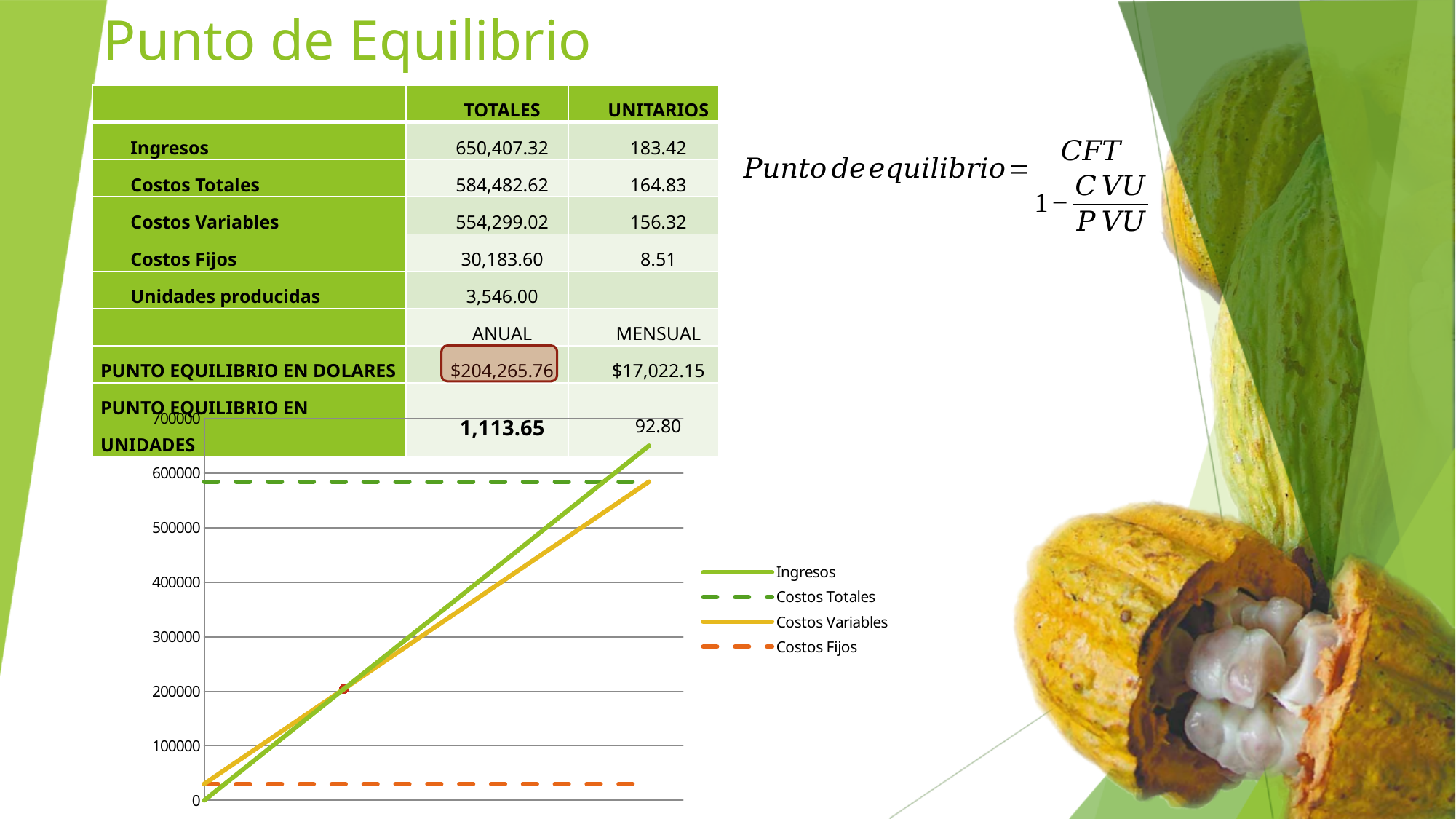
Is the Costos Totales line greater or less than 500000? greater Is the Costos Fijos line greater or less than 100000? less At the right end of the chart, is the Ingresos line greater or less than 600000? greater At the right end of the chart, which is higher: the Ingresos line or the Costos Variables line? Ingresos Which series is plotted as an orange dashed line? Costos Fijos Does the Costos Variables line rise or fall along the x axis? rise Which of the two horizontal dashed lines is higher: Costos Totales or Costos Fijos? Costos Totales What kind of chart is shown on the slide? line chart Does the Ingresos line rise or fall along the x axis? rise How many series does the chart's legend list? 4 Which series are listed in the chart's legend? Ingresos, Costos Totales, Costos Variables, Costos Fijos